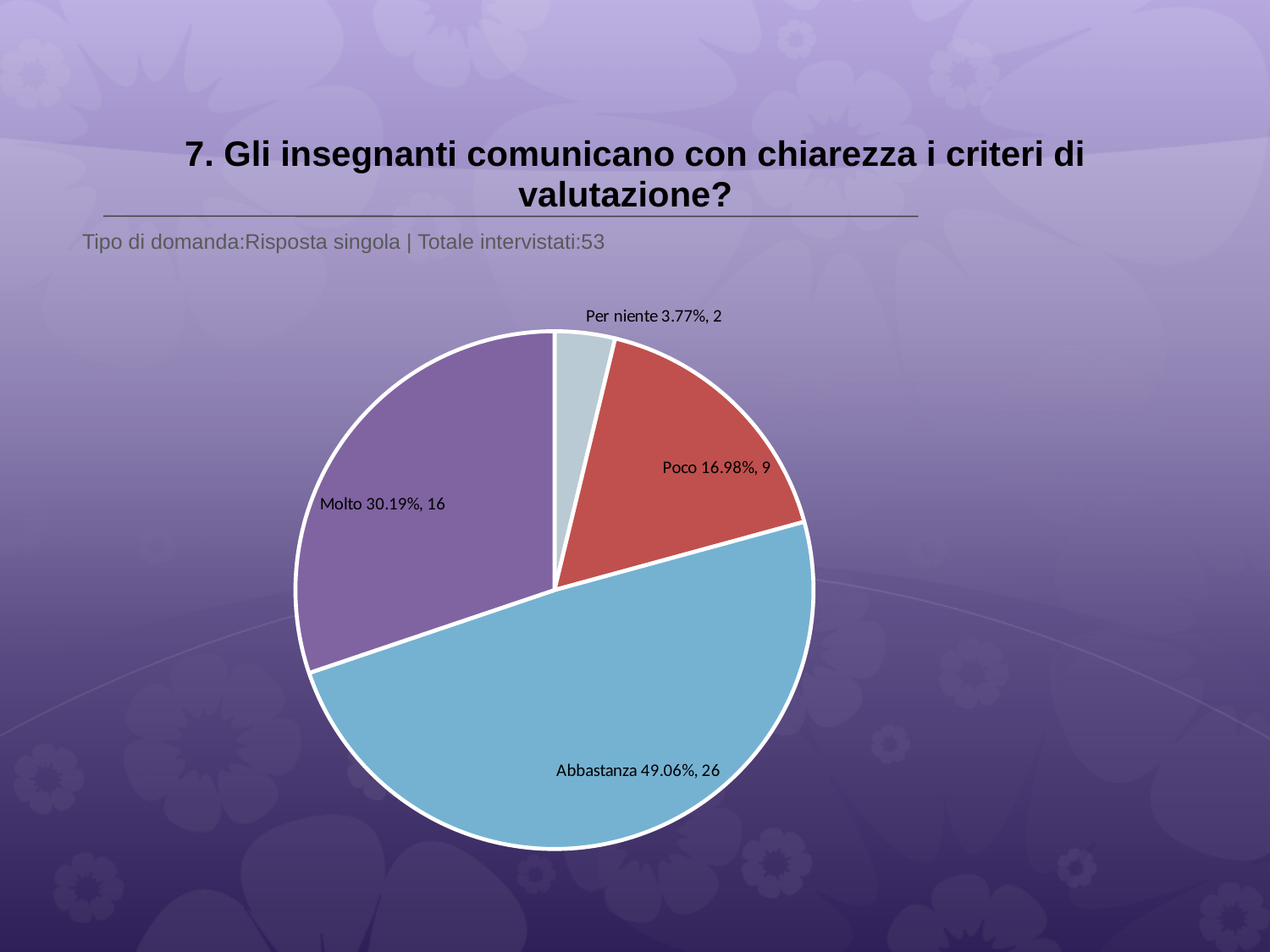
How many respondents answered 'Molto'? 16 What colour is the 'Abbastanza' slice? blue What is the total number of respondents shown in the subtitle? 53 What percentage share does the 'Abbastanza' slice have? 49.06% Which has more respondents, 'Poco' or 'Molto'? Molto How many slices does the pie chart have? 4 What is the difference in respondent count between 'Abbastanza' and 'Molto'? 10 What percentage share does the 'Per niente' slice have? 3.77% Which category has the smallest slice? Per niente How many respondents answered 'Poco'? 9 What kind of chart is shown on the slide? pie chart Which category has the largest slice? Abbastanza